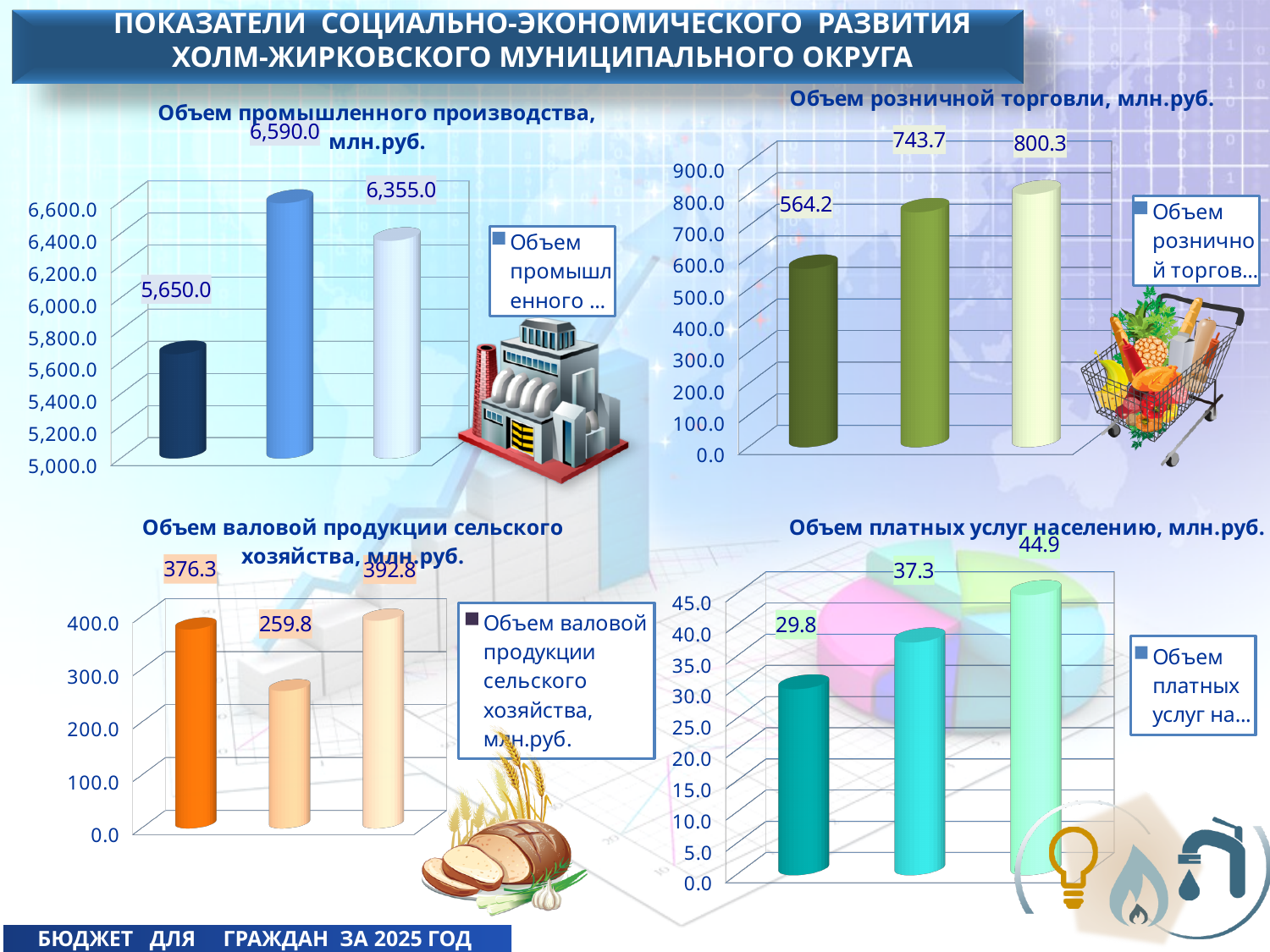
On the chart 'Объем валовой продукции сельского хозяйства, млн.руб.', what is the difference between the third bar (392.8) and the second bar (259.8)? 133.0 On the chart 'Объем валовой продукции сельского хозяйства, млн.руб.', which is larger: the first bar or the third bar? the third bar On the chart 'Объем промышленного производства, млн.руб.', which bar is the highest: the first, second or third? the second On the chart 'Объем платных услуг населению, млн.руб.', what is the value of the first (leftmost) bar? 29.8 On the chart 'Объем платных услуг населению, млн.руб.', how many bars are plotted? 3 What type of chart is 'Объем платных услуг населению, млн.руб.'? bar chart On the chart 'Объем розничной торговли, млн.руб.', which bar is the lowest: the first, second or third? the first On the chart 'Объем валовой продукции сельского хозяйства, млн.руб.', what is the value of the second (middle) bar? 259.8 On the chart 'Объем розничной торговли, млн.руб.', do the values rise or fall from left to right? rise On the chart 'Объем промышленного производства, млн.руб.', what is the difference between the second bar (6,590.0) and the third bar (6,355.0)? 235.0 On the chart 'Объем промышленного производства, млн.руб.', what is the value of the first (leftmost) bar? 5,650.0 On the chart 'Объем розничной торговли, млн.руб.', what is the value of the third (rightmost) bar? 800.3